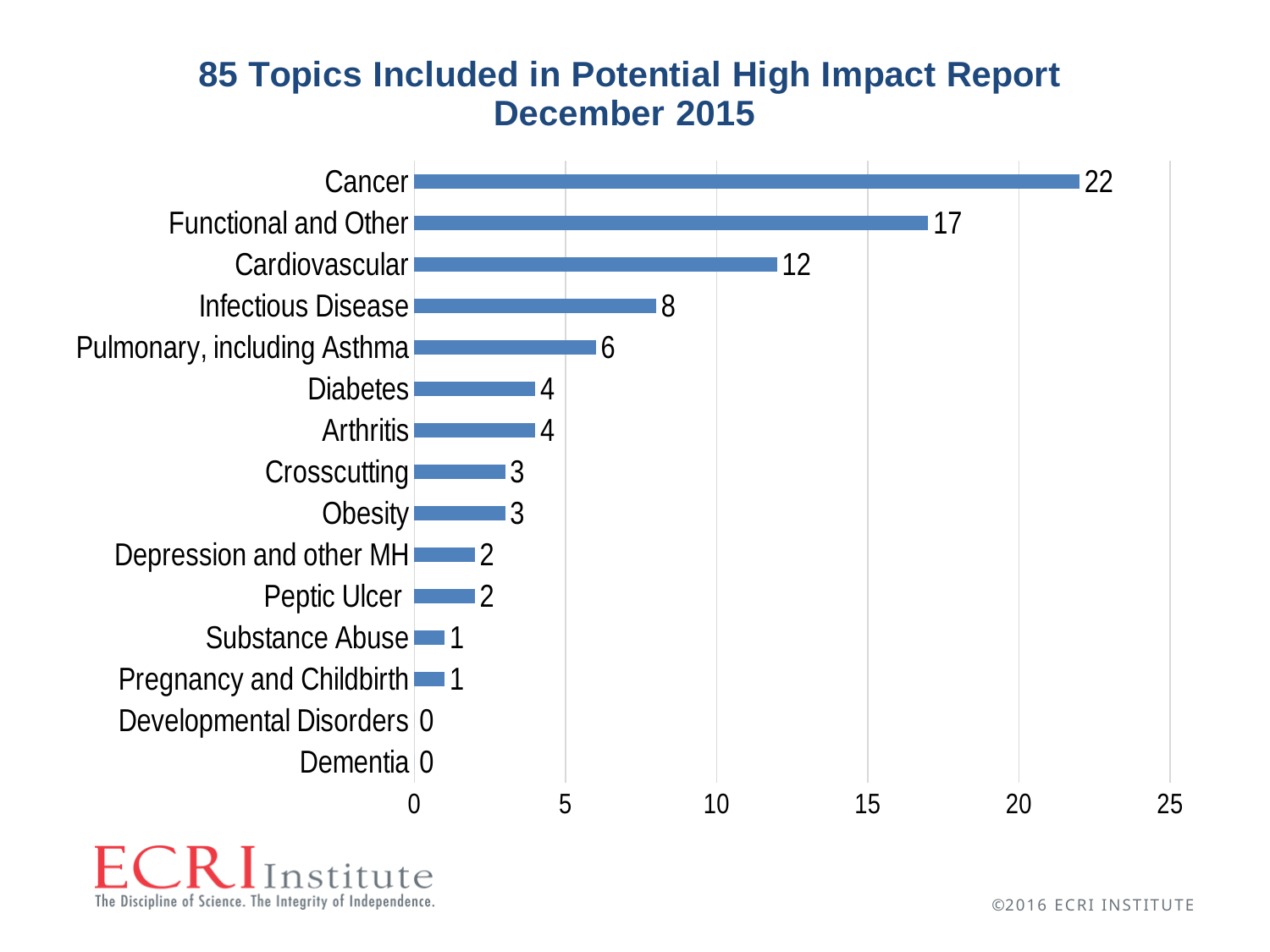
What is the title of the chart? 85 Topics Included in Potential High Impact Report December 2015 Which category has the highest value? Cancer Which is larger, the value for Cardiovascular or the value for Infectious Disease? Cardiovascular What kind of chart is shown on the slide? Bar chart What is the value for Pulmonary, including Asthma? 6 What is the difference between the values for Cancer and Functional and Other? 5 How many categories are shown in the chart? 15 How many categories have a value of 0? 2 Is the value for Functional and Other greater or less than 15? greater What is the value for Cardiovascular? 12 What is the difference between the values for Infectious Disease and Diabetes? 4 What is the value for Cancer? 22